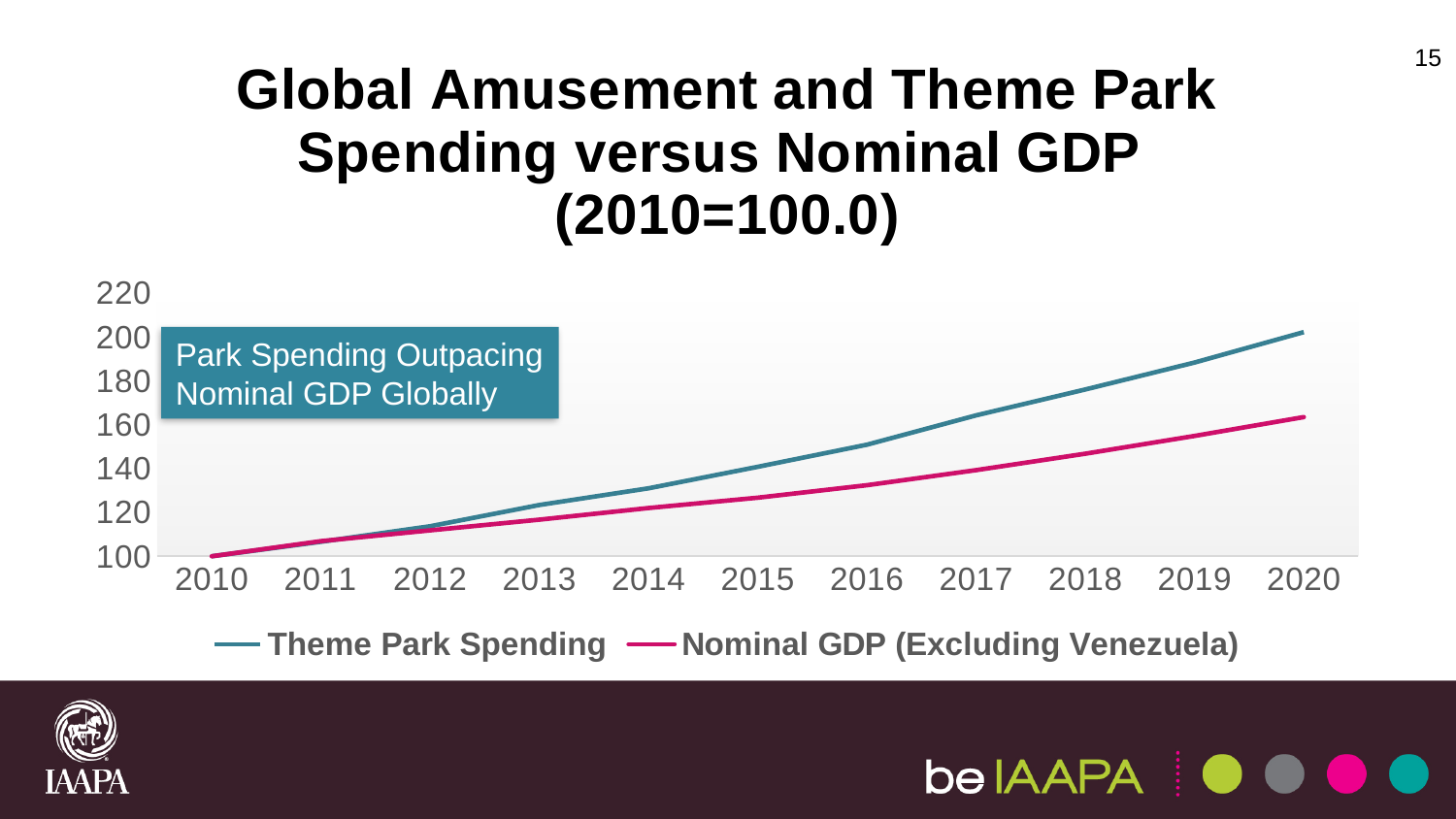
What is the text in the annotation box on the chart? Park Spending Outpacing Nominal GDP Globally Is the value for Theme Park Spending in 2017 greater or less than 140? greater What kind of chart is shown on the slide? line chart In 2020, which series is higher: Theme Park Spending or Nominal GDP (Excluding Venezuela)? Theme Park Spending Is the value for Nominal GDP (Excluding Venezuela) in 2020 greater or less than 180? less How many years are shown along the x axis? 11 Does the Nominal GDP (Excluding Venezuela) line rise or fall from 2010 to 2020? rise Is the value for Theme Park Spending in 2020 greater or less than 180? greater Which series is drawn in pink? Nominal GDP (Excluding Venezuela) Does the Theme Park Spending line rise or fall from 2010 to 2020? rise How many series does the legend list? 2